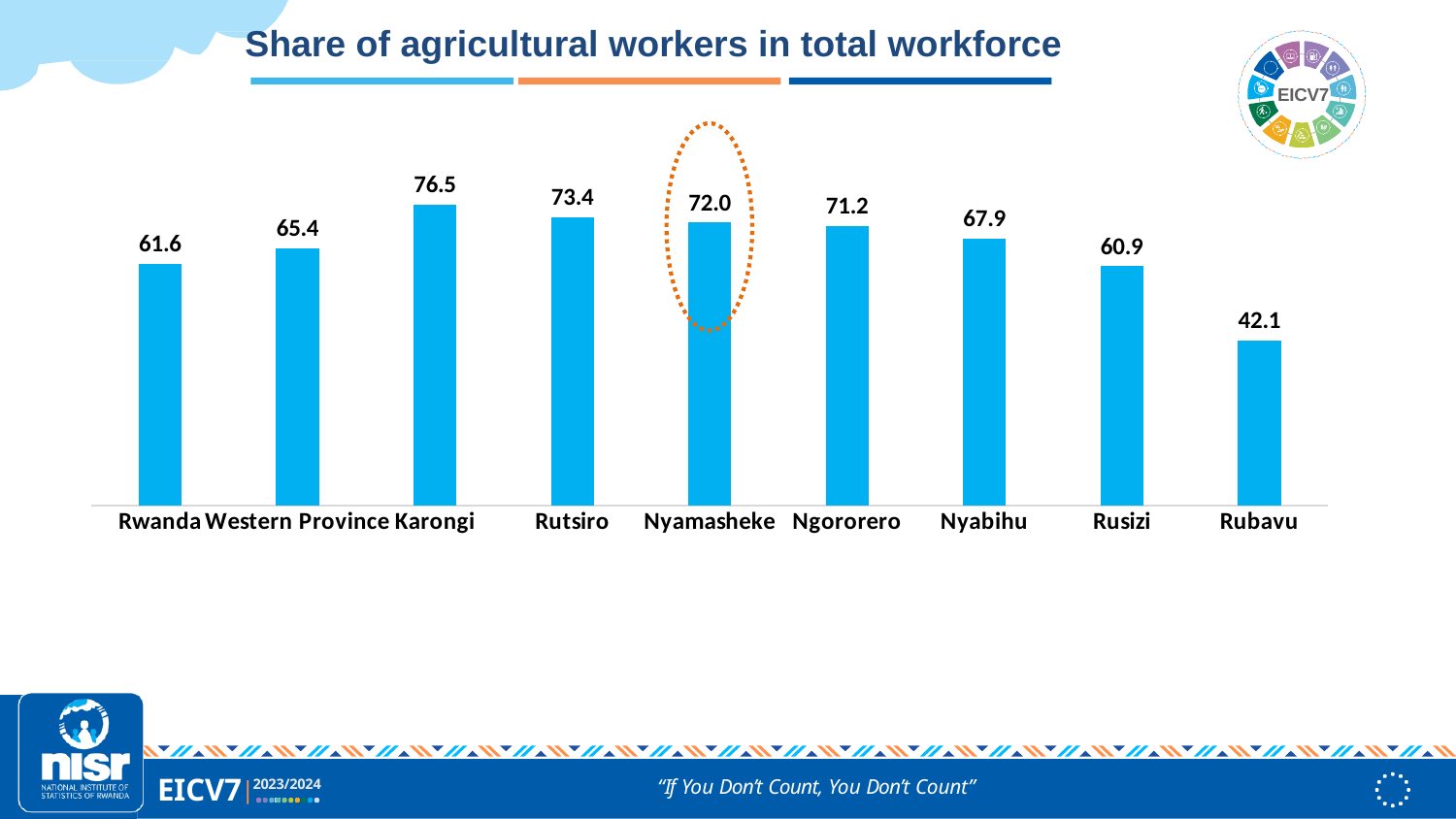
What is the value for Rubavu? 42.1 What is the title of the chart? Share of agricultural workers in total workforce What is the value for Karongi? 76.5 What is the value for Rwanda? 61.6 What is the difference between the values for Western Province and Rwanda? 3.8 Which category has the highest value? Karongi Which is larger, the value for Rutsiro or the value for Ngororero? Rutsiro What kind of chart is shown on the slide? Bar chart What is the difference between the values for Karongi and Rubavu? 34.4 How many categories are shown in the chart? 9 Which category has the lowest value? Rubavu What is the value for Nyamasheke? 72.0